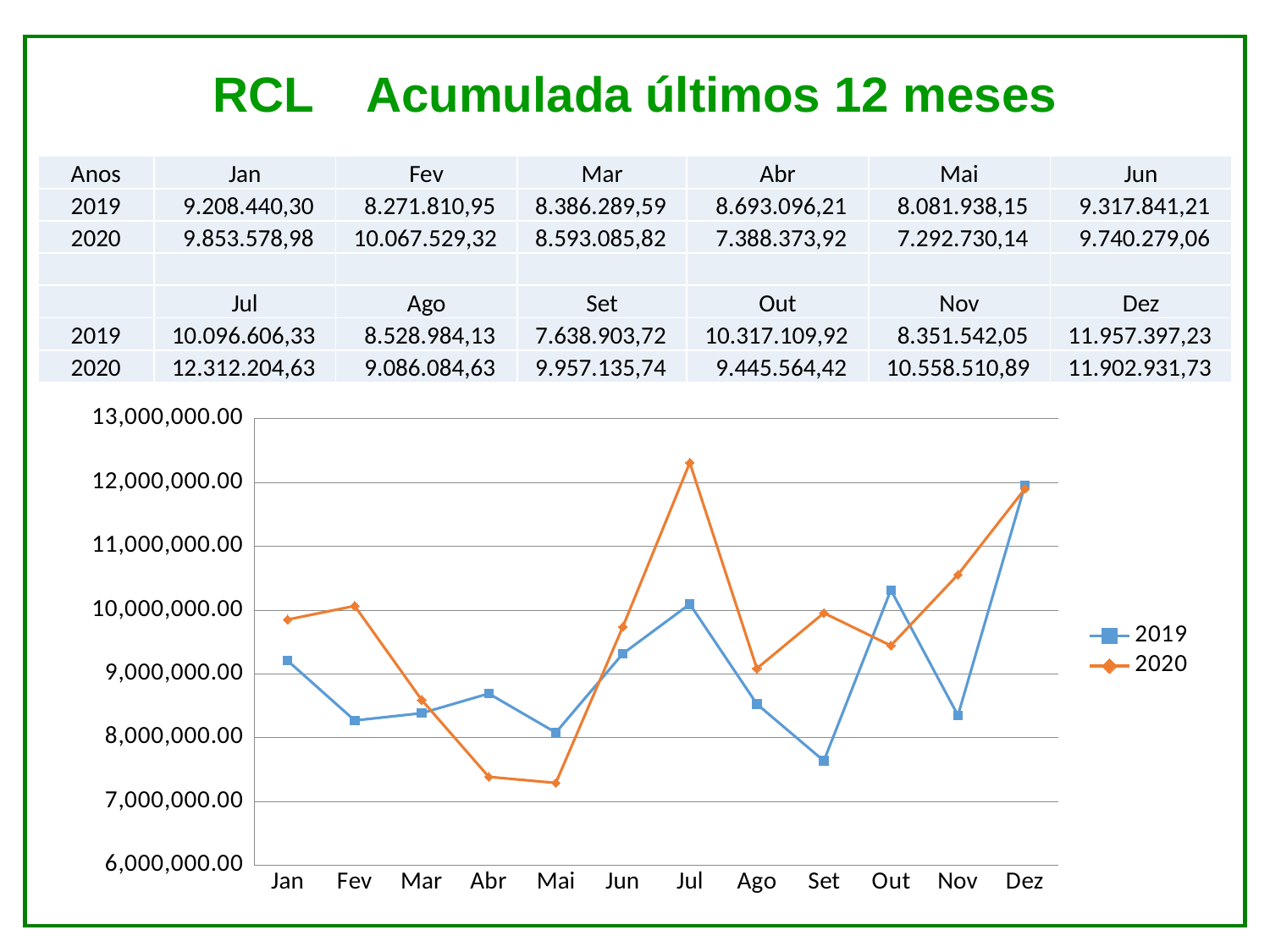
What is the 2019 value for Jan? 9.208.440,30 What is the difference between the 2020 and 2019 values for Jul? 2.215.598,30 How many series does the legend list? 2 How many months are plotted on the x axis? 12 Is the 2020 value for Jul greater or less than 12,000,000.00? greater Which is larger for Abr, the 2019 value or the 2020 value? 2019 What is the 2020 value for Mai? 7.292.730,14 Which month has the highest value for the 2020 series? Jul Is the 2019 value for Set greater or less than 8,000,000.00? less Which month has the lowest value for the 2019 series? Set What kind of chart is shown on the slide? line chart Does the 2020 series rise or fall from Abr to Jul? rise